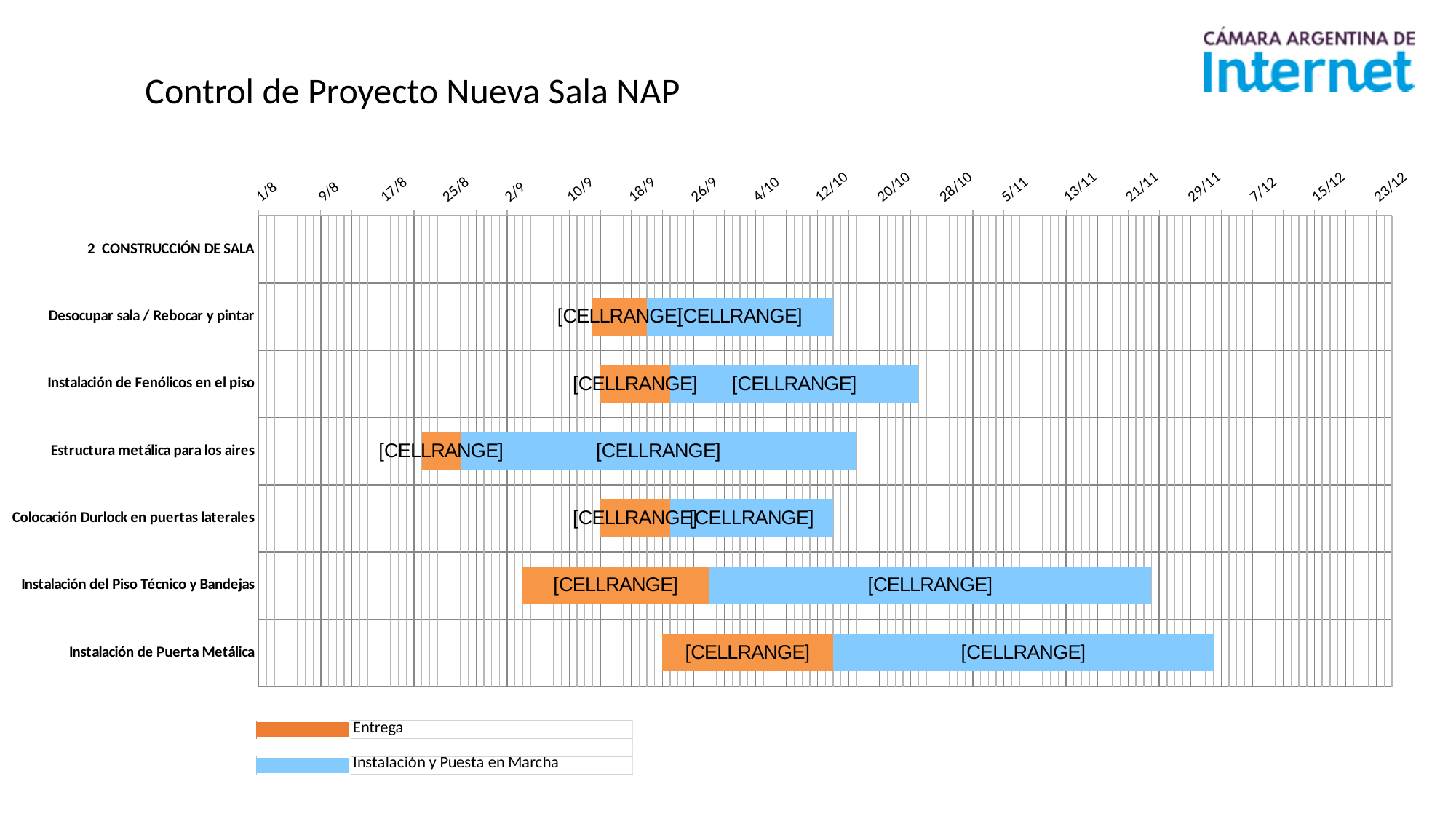
Which legend entry is shown in orange? Entrega How many task rows are listed on the vertical axis of the chart? 7 How many series does the legend list? 2 How many tasks have bars plotted in the chart? 6 Which task starts earliest in the chart? Estructura metálica para los aires Which task ends latest in the chart? Instalación de Puerta Metálica Does the bar for Instalación de Puerta Metálica end before or after 21/11? after Which task has the longest overall bar in the chart? Instalación del Piso Técnico y Bandejas What is the title of the slide? Control de Proyecto Nueva Sala NAP What kind of chart is shown on the slide? Bar chart (Gantt chart) Which task has the shortest Entrega (orange) segment? Estructura metálica para los aires Does the bar for Estructura metálica para los aires start before or after 2/9? before